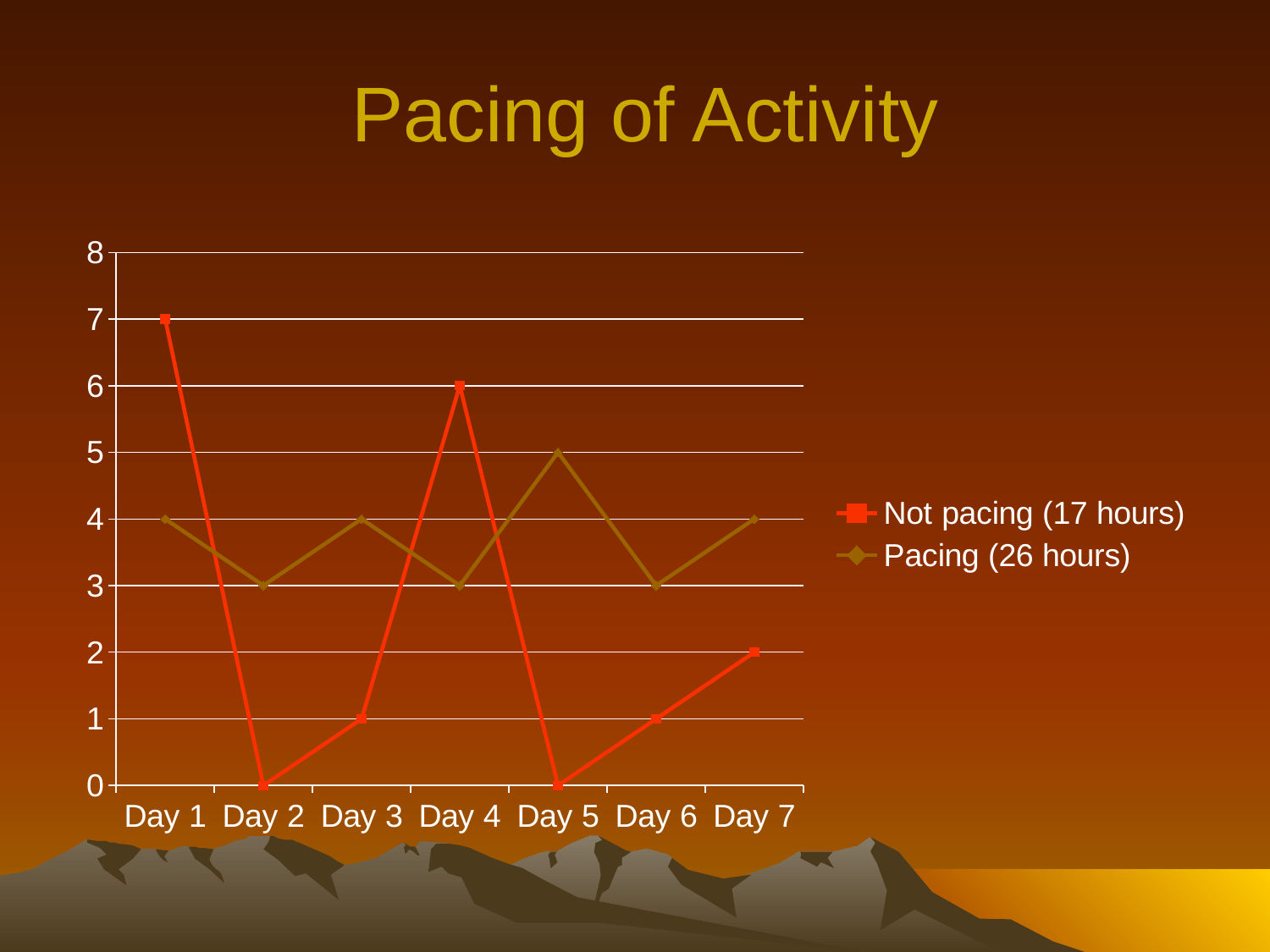
What kind of chart is shown on the slide? Line chart What is the value for Not pacing (17 hours) on Day 1? 7 On which day is the Pacing (26 hours) series highest? Day 5 On which day is the Not pacing (17 hours) series highest? Day 1 How many series does the legend list? 2 How many days are plotted along the x axis? 7 Which series has the larger value on Day 2, Not pacing (17 hours) or Pacing (26 hours)? Pacing (26 hours) What is the difference between the Not pacing (17 hours) and Pacing (26 hours) values on Day 1? 3 What is the value for Pacing (26 hours) on Day 5? 5 What is the value for Not pacing (17 hours) on Day 4? 6 Does the Not pacing (17 hours) series rise or fall from Day 5 to Day 7? Rise What is the title of the chart? Pacing of Activity